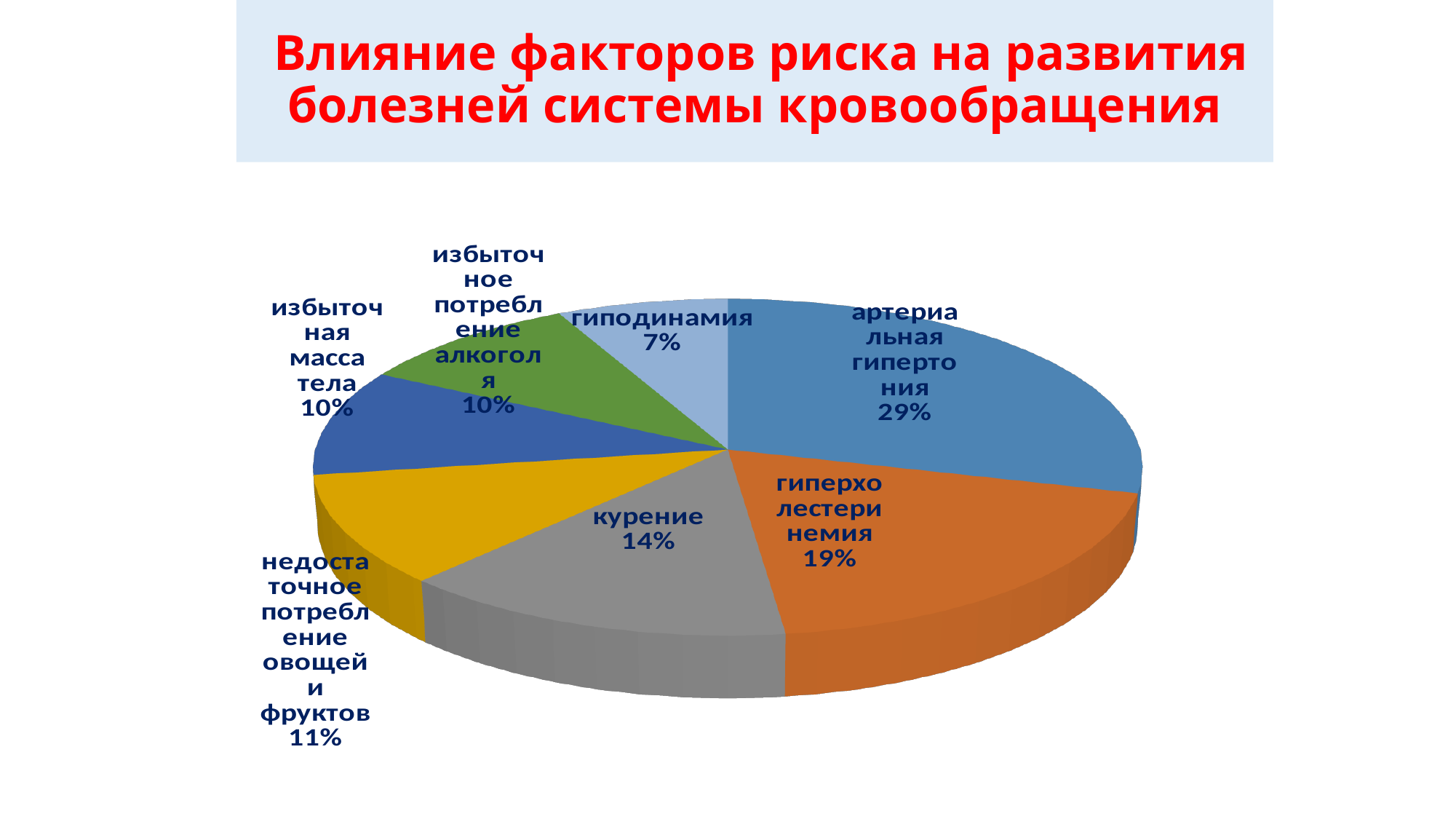
What kind of chart is shown on the slide? Pie chart Which is larger, the value for курение or the value for избыточная масса тела? курение What is the title of the slide? Влияние факторов риска на развития болезней системы кровообращения What is the value shown for гиподинамия? 7% What share of the pie does артериальная гипертония have? 29% How many slices does the pie chart have? 7 What is the difference between the values for артериальная гипертония and гиперхолестеринемия? 10% What is the value shown for гиперхолестеринемия? 19% Which risk factor has the largest slice of the pie? артериальная гипертония What is the value shown for недостаточное потребление овощей и фруктов? 11% Which risk factor has the smallest slice of the pie? гиподинамия What is the value shown for курение? 14%